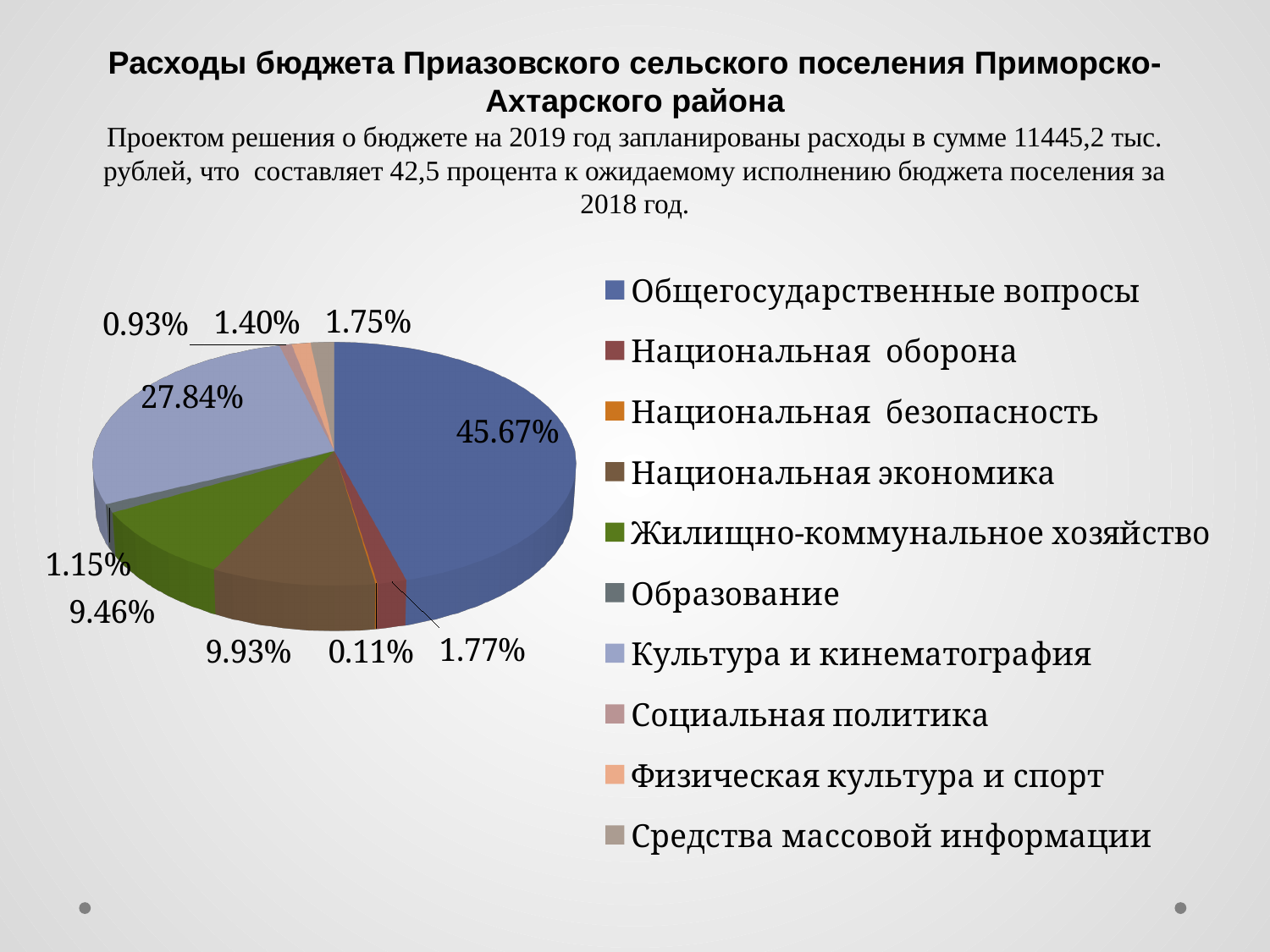
Which category has the largest share of the pie? Общегосударственные вопросы What share of the pie does Жилищно-коммунальное хозяйство have? 9.46% What kind of chart is shown on the slide? pie chart What share of the pie does Культура и кинематография have? 27.84% What share of the pie does Общегосударственные вопросы have? 45.67% What share of the pie does Национальная безопасность have? 0.11% What share of the pie does Средства массовой информации have? 1.75% How many categories does the legend list? 10 Which category has the smallest share of the pie? Национальная безопасность What share of the pie does Национальная экономика have? 9.93% Which has a larger share, Национальная экономика or Жилищно-коммунальное хозяйство? Национальная экономика What is the difference between the shares of Общегосударственные вопросы and Культура и кинематография? 17.83%